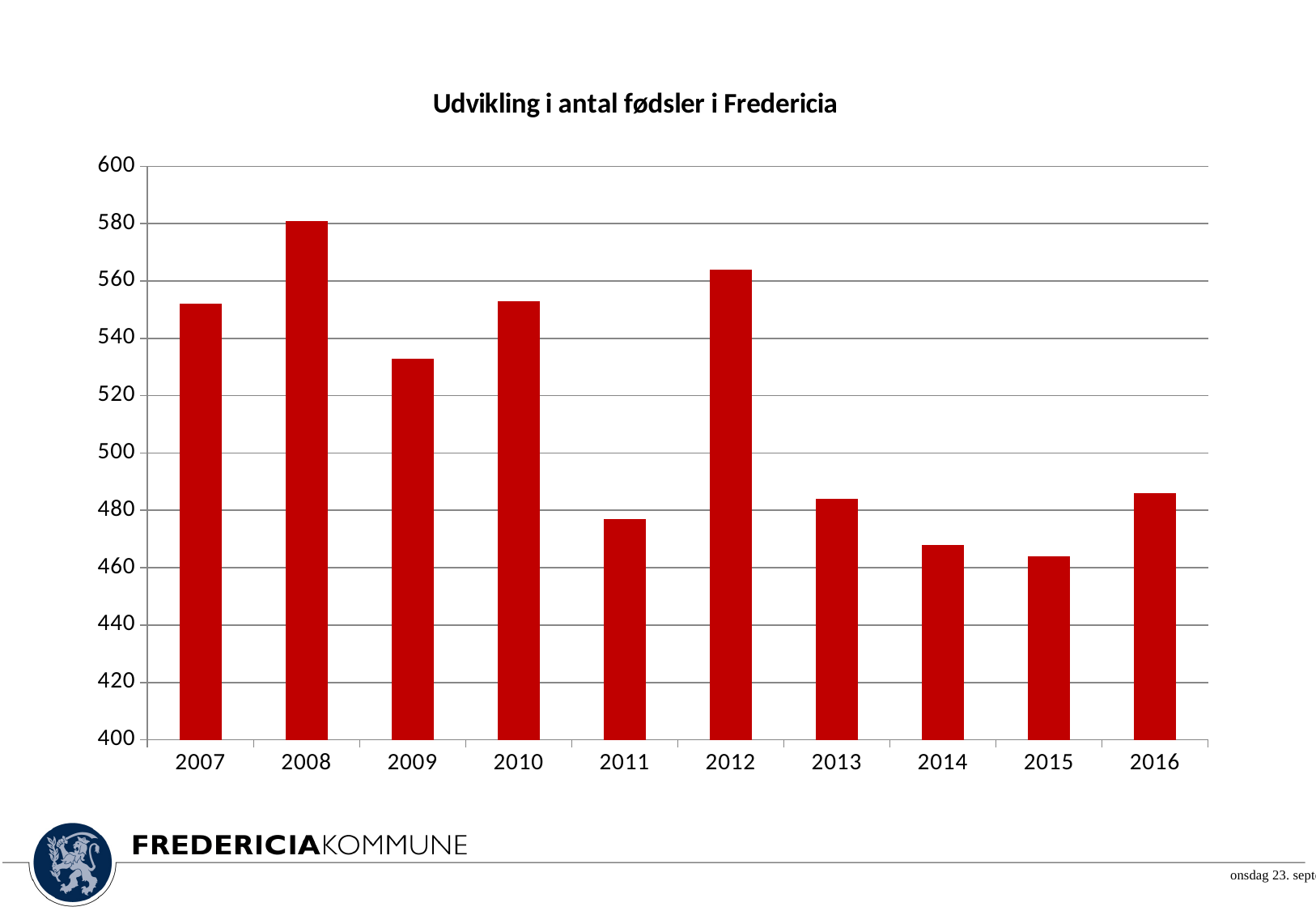
Is the value for 2011 greater or less than 480? less Which is larger, the value for 2009 or the value for 2013? 2009 What is the title of the chart? Udvikling i antal fødsler i Fredericia Is the value for 2009 greater or less than 540? less Do the values generally rise or fall from 2012 to 2015? fall How many years are shown on the x axis of the chart? 10 What type of chart is shown on the slide? bar chart Which year has the highest number of births in the chart? 2008 Which is larger, the value for 2008 or the value for 2012? 2008 Is the value for 2008 greater or less than 560? greater